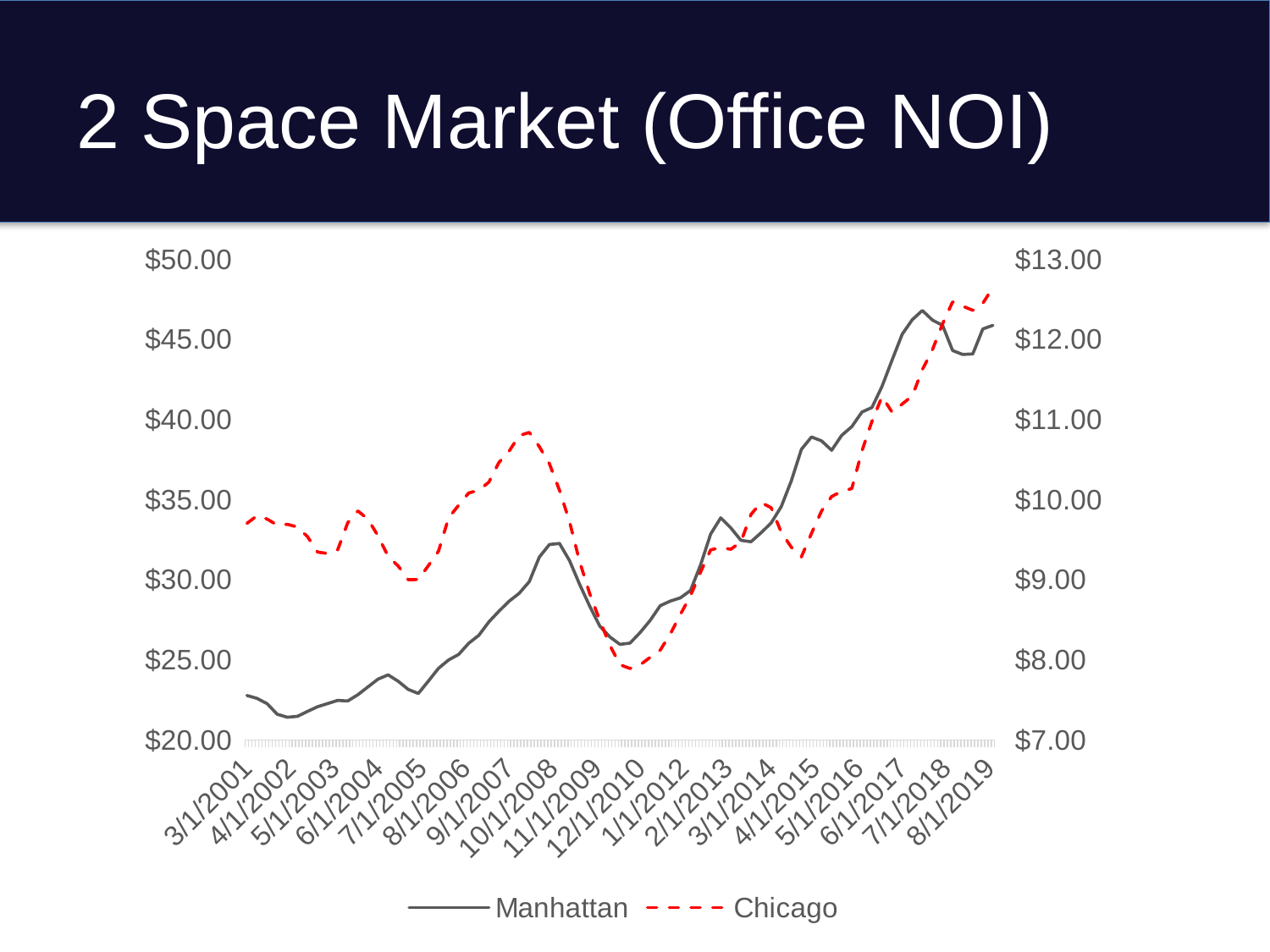
Is the Chicago value at 12/1/2010 greater or less than $9.00 on the right axis? less Is the Manhattan value at 3/1/2001 greater or less than $25.00 on the left axis? less Is the Chicago value at 8/1/2019 greater or less than $12.00 on the right axis? greater Which series is drawn with a red dashed line? Chicago Is the Manhattan value higher at 8/1/2019 or at 3/1/2001? 8/1/2019 How many series does the legend list? 2 Overall, do the Manhattan values rise or fall from 3/1/2001 to 8/1/2019? rise What kind of chart is shown on the slide? line chart What is the title of the slide containing the chart? 2 Space Market (Office NOI)